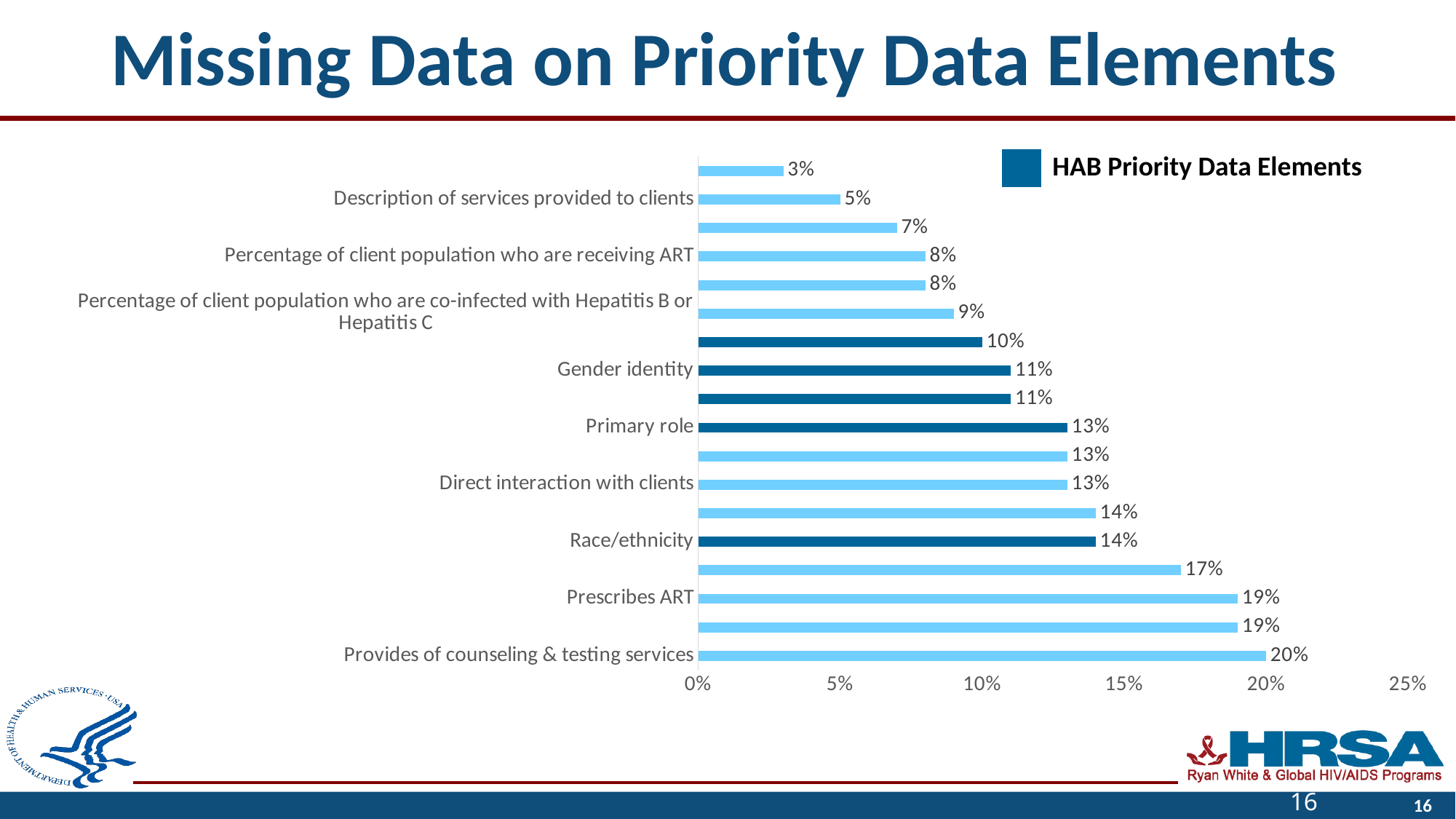
What is the value for Percentage of client population who are co-infected with Hepatitis B or Hepatitis C? 9% Which labeled category has the highest value? Provides of counseling & testing services What is the value for Gender identity? 11% Which is larger, the value for Prescribes ART or the value for Primary role? Prescribes ART What is the difference between the values for Provides of counseling & testing services and Description of services provided to clients? 15 percentage points What is the value for Race/ethnicity? 14% What is the value for Provides of counseling & testing services? 20% How many bars are plotted on the chart? 18 What kind of chart is shown on the slide? Bar chart Is the value for Race/ethnicity greater or less than 10%? greater What is the smallest value shown on the chart? 3% What is the value for Description of services provided to clients? 5%